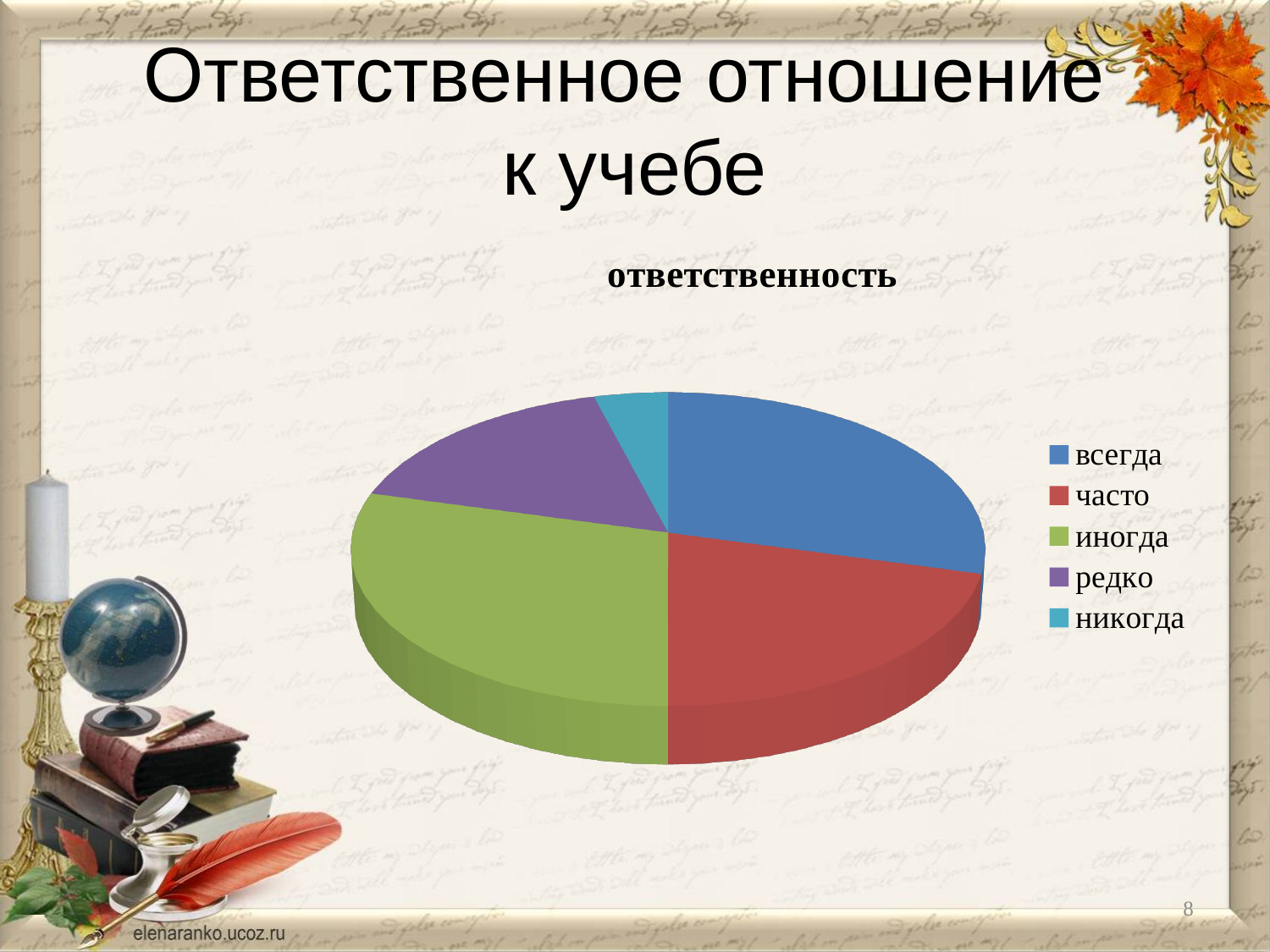
Which slice is larger, всегда or редко? всегда Which colour represents the category никогда in the chart? light blue Which slice is larger, редко or никогда? редко How many entries does the legend list? 5 How many categories does the pie chart have? 5 Which category has the smallest slice of the pie? никогда Which slice is larger, часто or никогда? часто What kind of chart is shown on the slide? pie chart What is the title of the chart? ответственность